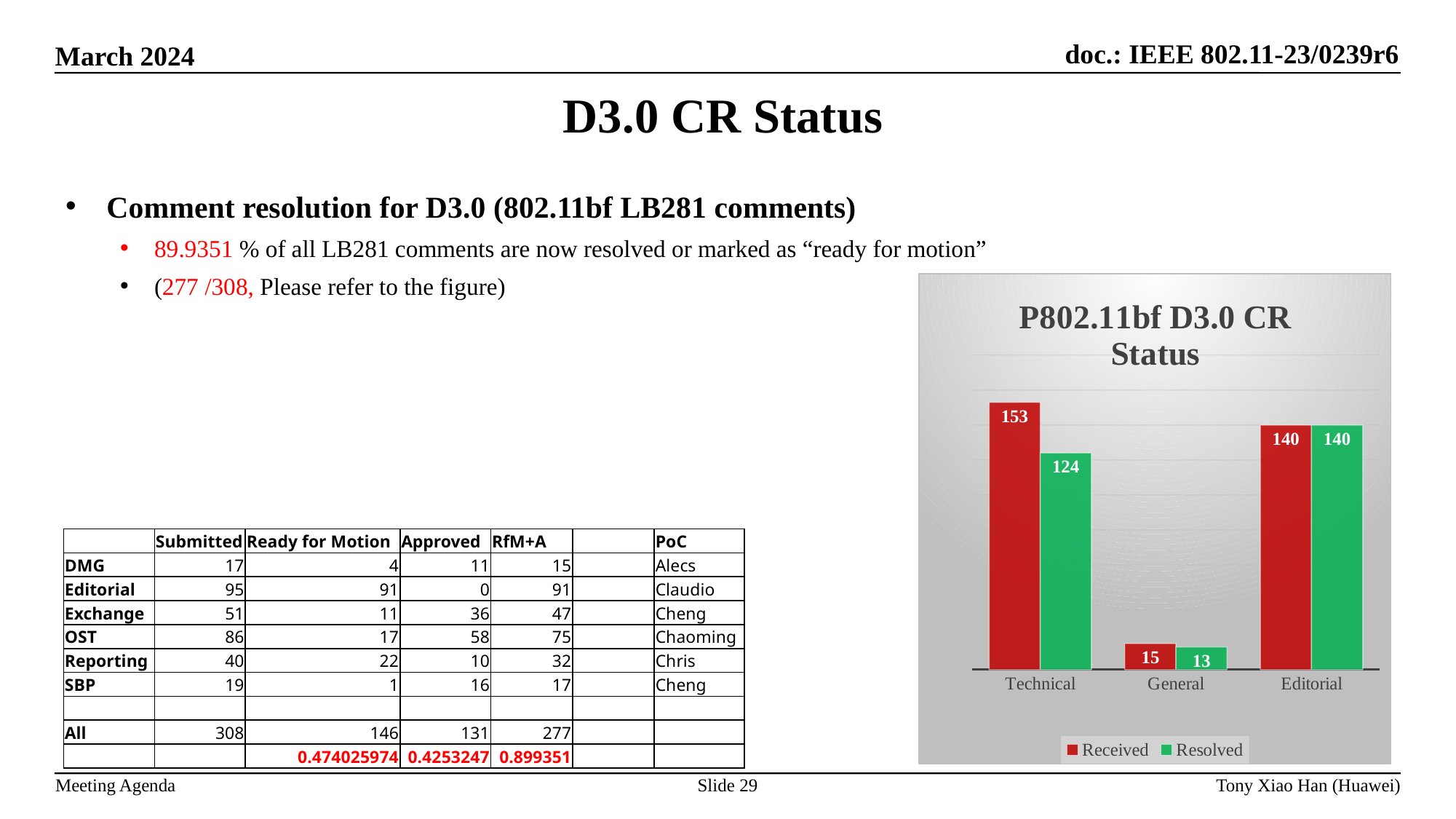
Which category has the lowest Resolved value in the P802.11bf D3.0 CR Status chart? General What is the Resolved value for General in the P802.11bf D3.0 CR Status chart? 13 What is the difference between Received and Resolved for General in the P802.11bf D3.0 CR Status chart? 2 How many categories are shown on the x axis of the P802.11bf D3.0 CR Status chart? 3 What is the difference between Received and Resolved for Technical in the P802.11bf D3.0 CR Status chart? 29 How many series does the legend of the P802.11bf D3.0 CR Status chart list? 2 Is the Received value for Technical larger than the Received value for Editorial in the P802.11bf D3.0 CR Status chart? Yes What is the Resolved value for Editorial in the P802.11bf D3.0 CR Status chart? 140 What kind of chart is the P802.11bf D3.0 CR Status chart? Bar chart Which category has the highest Received value in the P802.11bf D3.0 CR Status chart? Technical What is the Received value for Technical in the P802.11bf D3.0 CR Status chart? 153 Which colour represents the Resolved series in the P802.11bf D3.0 CR Status chart? Green